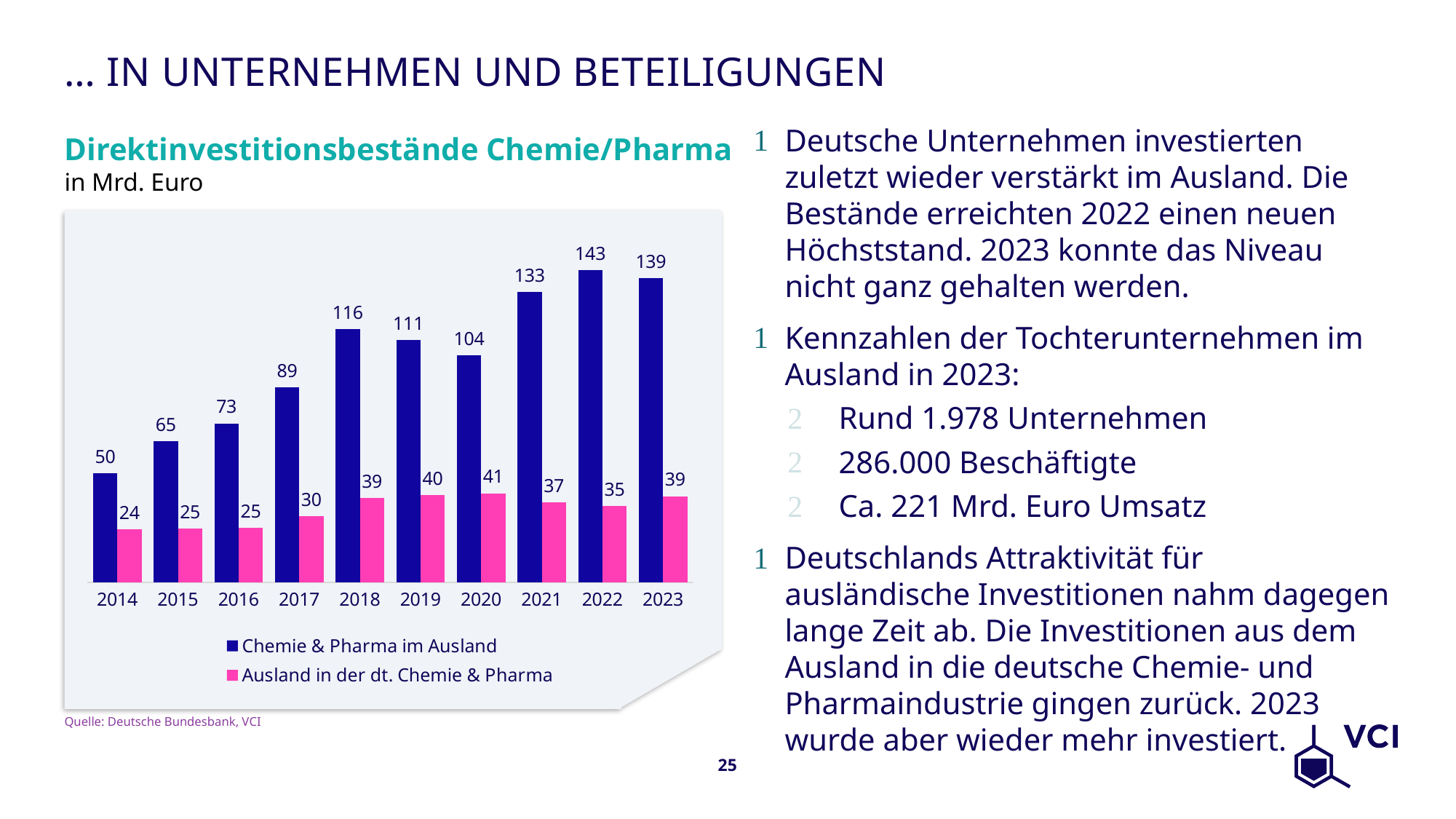
In which year is the "Ausland in der dt. Chemie & Pharma" series lowest? 2014 What is the difference between the two series in 2023? 100 Which is larger: the "Ausland in der dt. Chemie & Pharma" value in 2019 or in 2022? 2019 What unit is given in the chart subtitle? in Mrd. Euro What kind of chart is shown on the slide? Bar chart What is the value for "Chemie & Pharma im Ausland" in 2022? 143 In which year is the "Chemie & Pharma im Ausland" series highest? 2022 What is the value for "Ausland in der dt. Chemie & Pharma" in 2020? 41 How many series does the legend list? 2 Does the "Chemie & Pharma im Ausland" series rise or fall from 2014 to 2022? Rise What is the difference between the "Chemie & Pharma im Ausland" values for 2023 and 2014? 89 How many years are shown on the x axis of the chart? 10